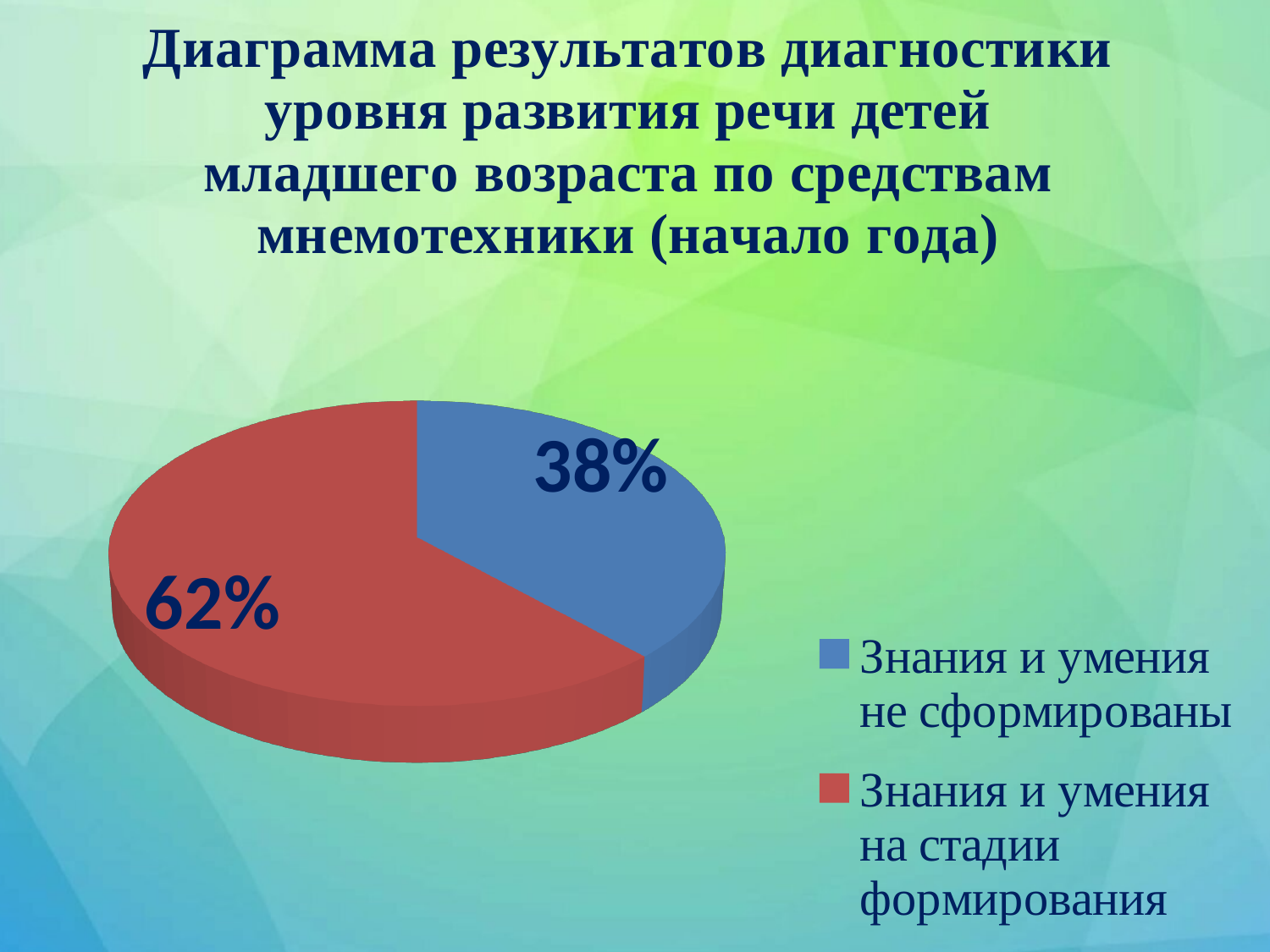
What colour is the slice for "Знания и умения на стадии формирования"? red How many entries does the legend list? 2 How many slices does the pie chart have? 2 What is the difference between the values for "Знания и умения на стадии формирования" and "Знания и умения не сформированы"? 24% What colour is the slice for "Знания и умения не сформированы"? blue Which category has the largest slice? Знания и умения на стадии формирования What is the value for "Знания и умения не сформированы"? 38% Which category has the smallest slice? Знания и умения не сформированы Which is larger: "Знания и умения не сформированы" or "Знания и умения на стадии формирования"? Знания и умения на стадии формирования What share of the pie does the red slice represent? 62% What kind of chart is shown on the slide? pie chart What is the value for "Знания и умения на стадии формирования"? 62%